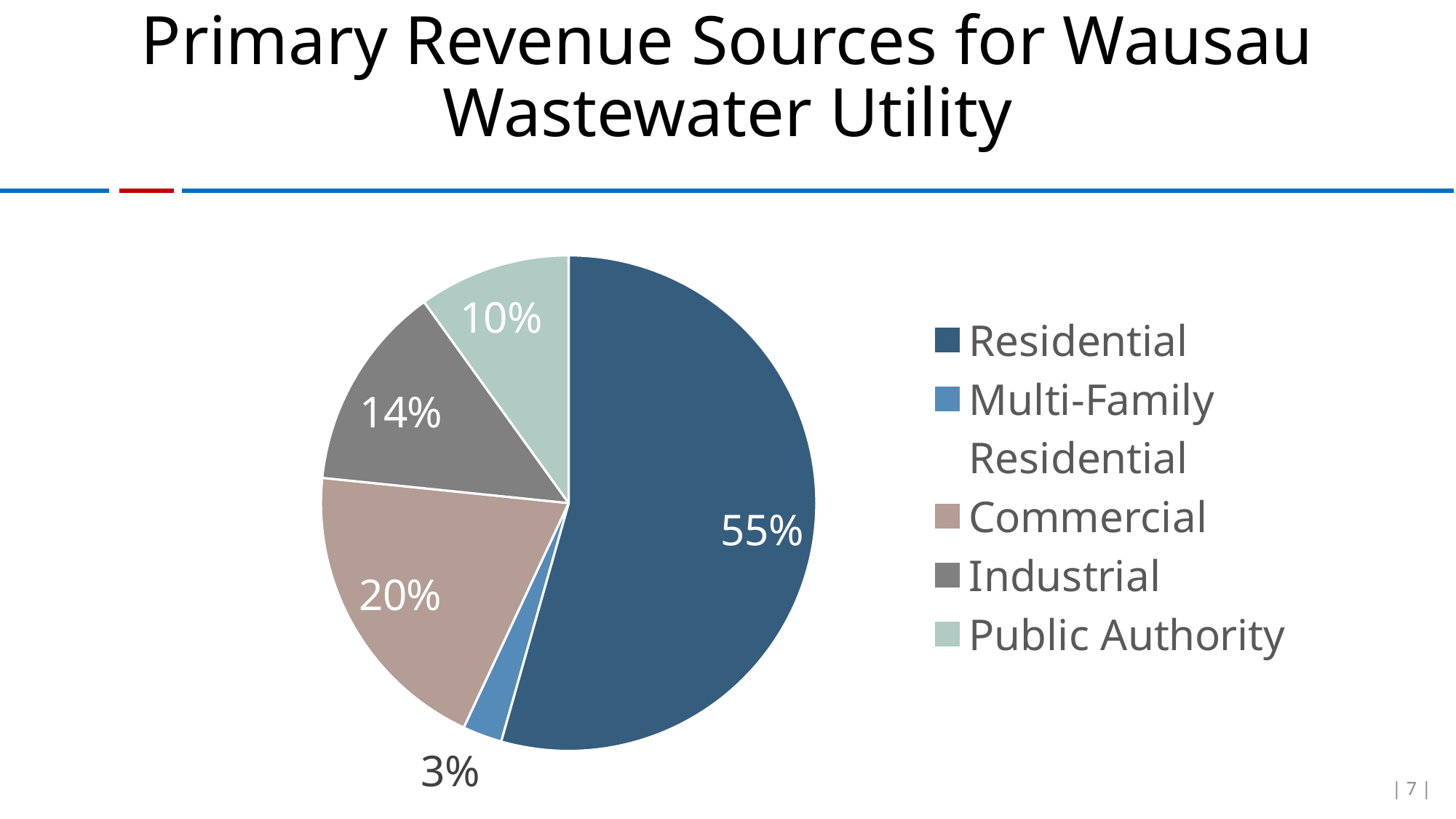
What share of revenue comes from Industrial? 14% What is the difference in percentage points between the Commercial and Industrial shares? 6 What share of revenue comes from Residential? 55% What share of revenue comes from Public Authority? 10% How many revenue sources are shown in the pie chart? 5 What type of chart is shown on the slide? Pie chart Which revenue source has the smallest share? Multi-Family Residential What share of revenue comes from Multi-Family Residential? 3% What share of revenue comes from Commercial? 20% Which is larger, the Industrial share or the Public Authority share? Industrial Which revenue source has the largest share? Residential What is the title of the slide? Primary Revenue Sources for Wausau Wastewater Utility